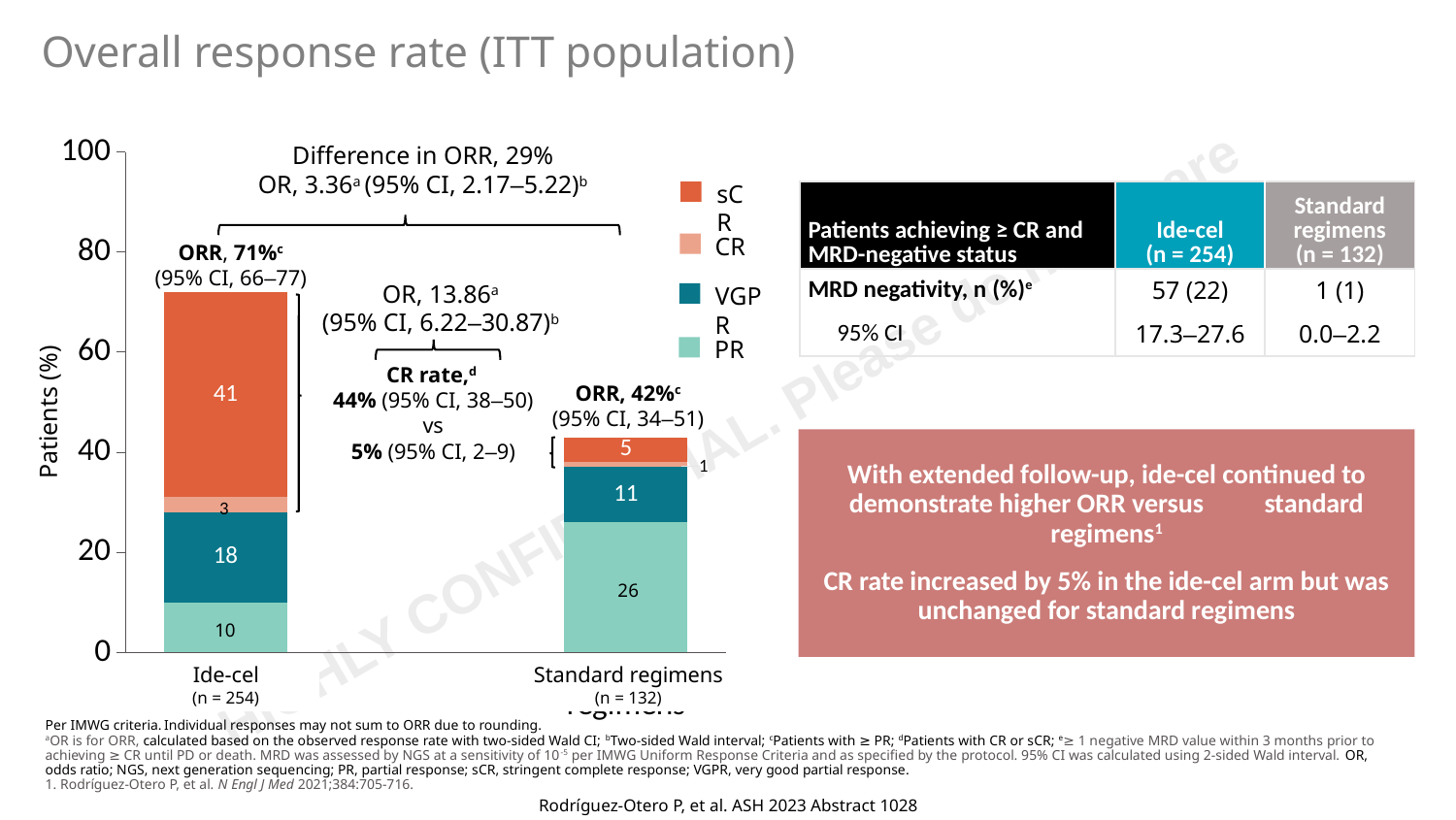
How many treatment groups (categories) are plotted on the x axis? 2 What type of chart is shown on the slide? Stacked bar chart What is the VGPR value for Ide-cel? 18 What is the difference between the PR values for Standard regimens and Ide-cel? 16 Which treatment group has the higher sCR value? Ide-cel What is the CR value for Standard regimens? 1 How many series does the chart legend list? 4 What ORR is labelled above the Ide-cel bar? 71% What is the difference between the VGPR values for Ide-cel and Standard regimens? 7 What is the sCR value for Ide-cel? 41 What is the PR value for Standard regimens? 26 Which segment is the largest within the Standard regimens bar? PR